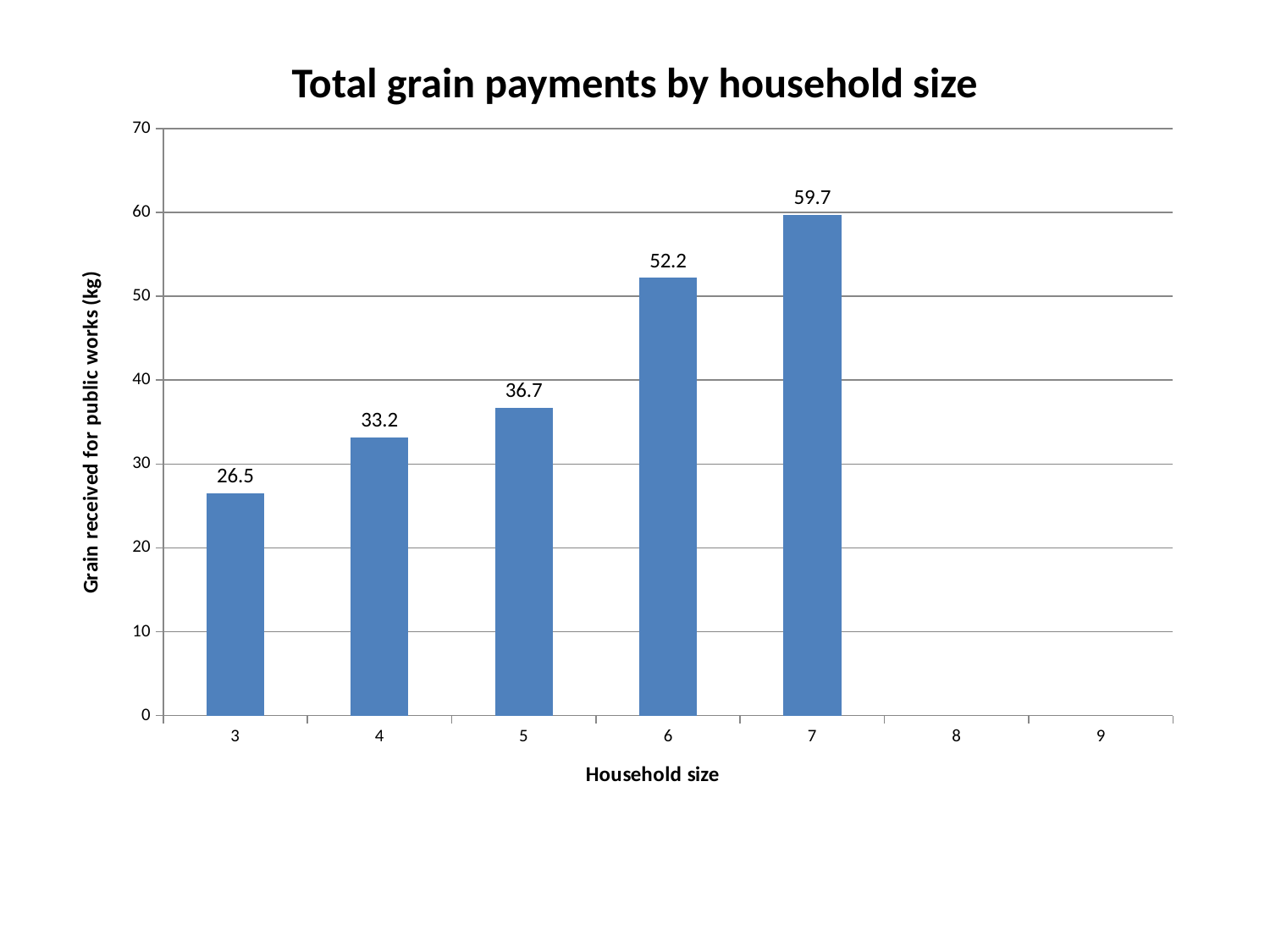
Is the value for household size 6 greater or less than 50? greater Which household size has the lowest grain payment among the plotted bars? 3 What is the grain received for household size 6? 52.2 What is the grain received for household size 7? 59.7 Which is larger, the grain payment for household size 4 or household size 5? Household size 5 What is the difference between the grain payments for household size 7 and household size 6? 7.5 Which household size has the highest grain payment? 7 How many household sizes have a bar plotted on the chart? 5 What is the difference between the grain payments for household size 5 and household size 4? 3.5 What kind of chart is shown on the slide? Bar chart Do the grain payments rise or fall as household size increases from 3 to 7? Rise What is the grain received for household size 3? 26.5